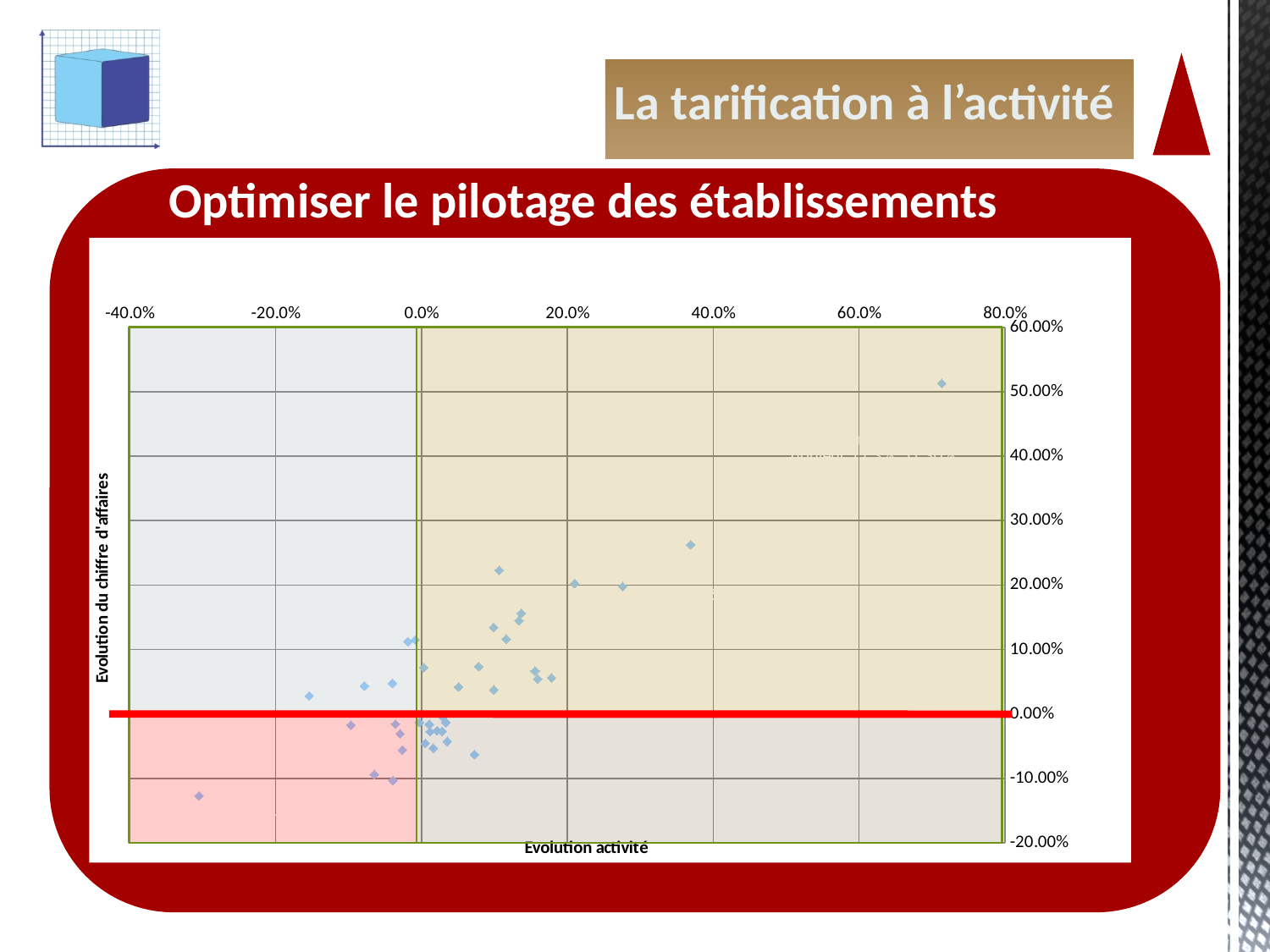
Is the highest plotted value on the vertical axis greater or less than 60.00%? less Is the lowest plotted value on the vertical axis (Evolution du chiffre d'affaires) greater or less than -10.00%? less What is the title of the vertical axis of the chart? Evolution du chiffre d'affaires At what vertical-axis value is the thick red horizontal line drawn on the chart? 0.00% What kind of chart is shown on the slide? Scatter chart What is the title of the horizontal axis of the chart? Evolution activité Is the highest plotted value on the vertical axis (Evolution du chiffre d'affaires) greater or less than 40.00%? greater